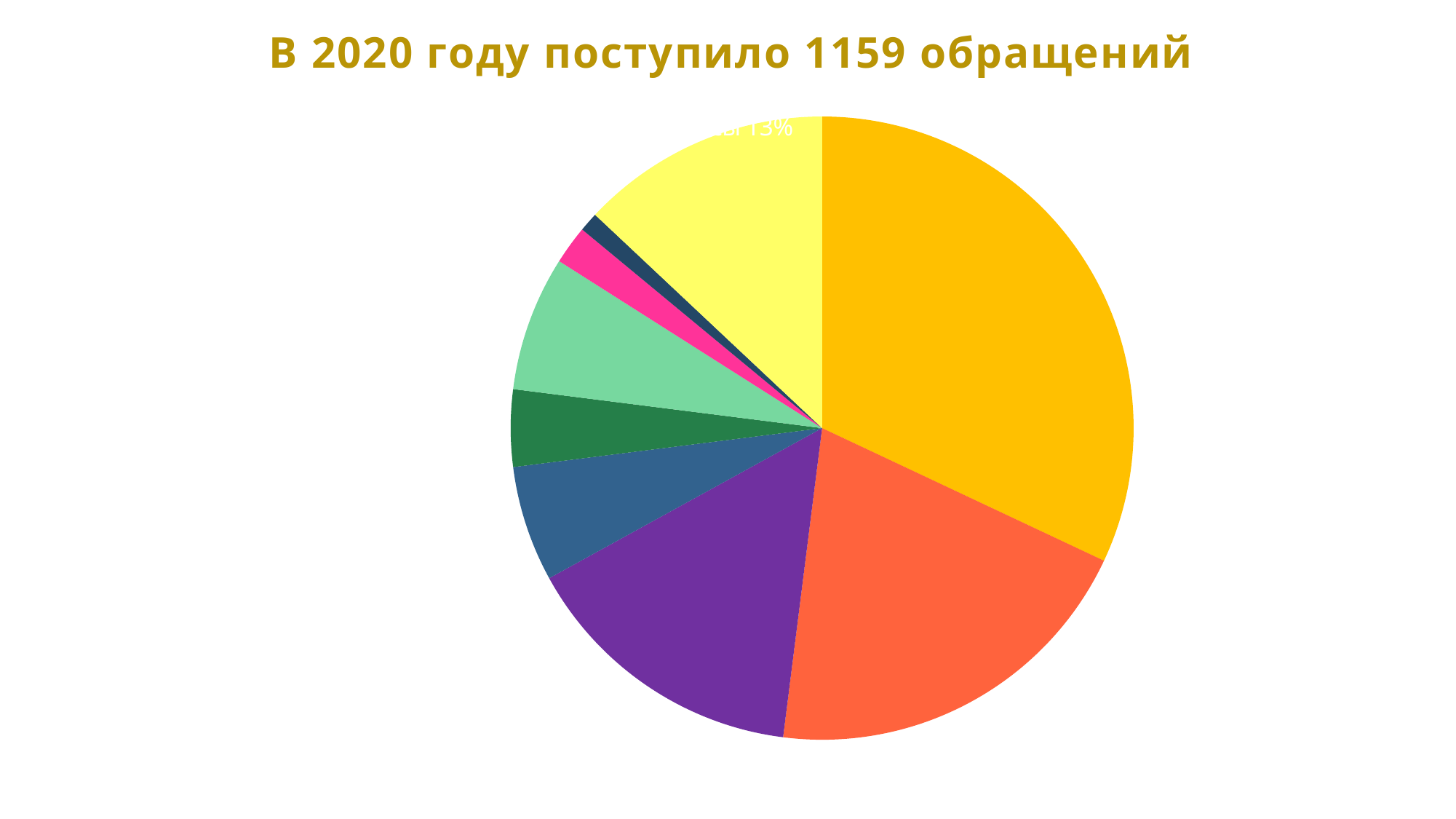
Which colour slice is the largest in the pie chart? orange (yellow-orange) What is the title of the chart? В 2020 году поступило 1159 обращений Which is larger, the red-orange slice or the purple slice? the red-orange slice How many obrashcheniy (appeals) does the title say were received in 2020? 1159 What percentage is printed on the light yellow slice? 13% How many slices does the pie chart have? 9 Which is larger, the purple slice or the blue slice? the purple slice Which colour slice is the smallest in the pie chart? dark navy blue Which is larger, the pink slice or the light green slice? the light green slice What kind of chart is shown on the slide? pie chart